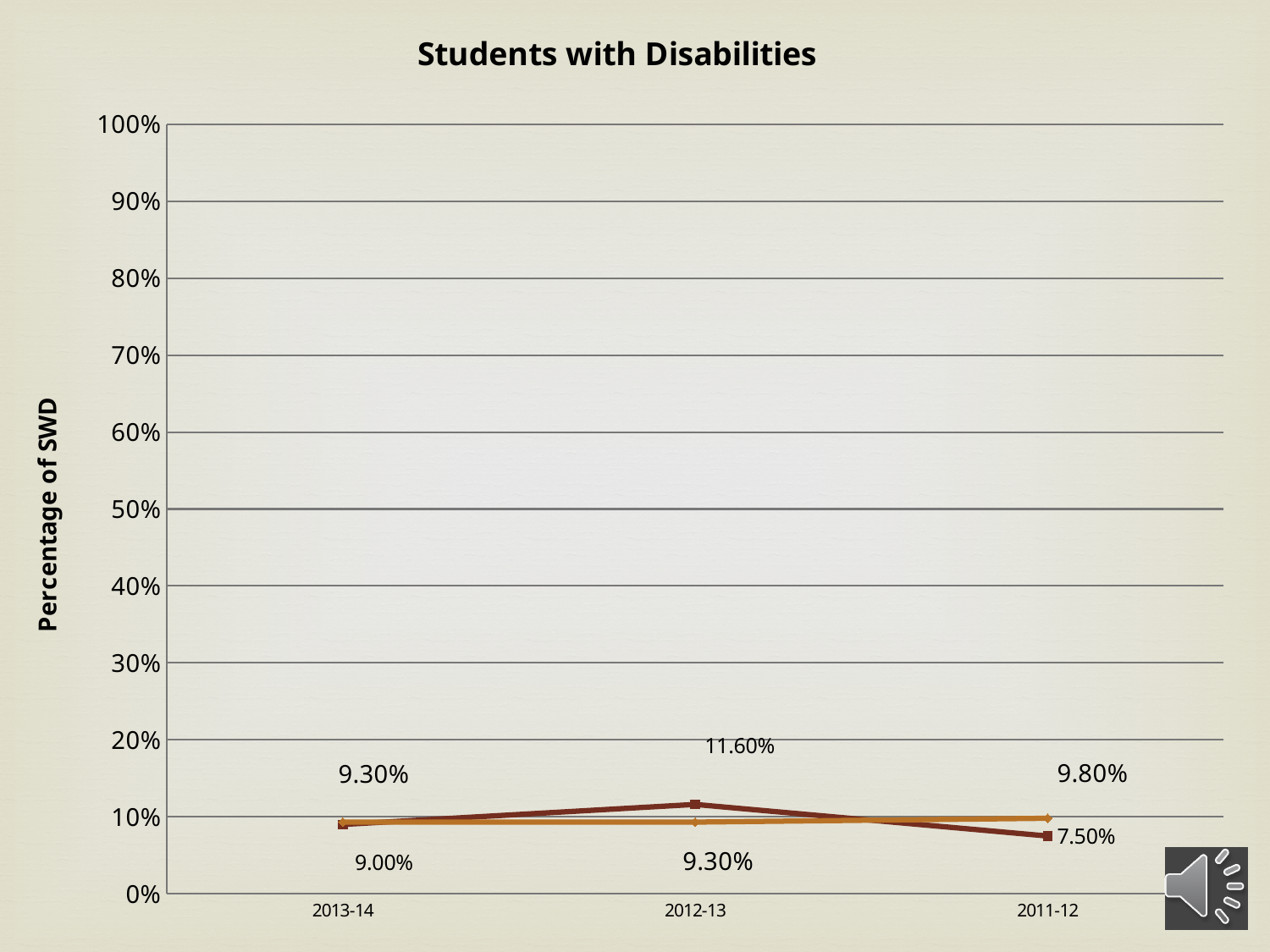
What is the label on the vertical axis of the chart? Percentage of SWD What is the value of the orange line with diamond markers for 2011-12? 9.80% What is the difference between the dark red line's value for 2012-13 (11.60%) and its value for 2011-12 (7.50%)? 4.10% For 2011-12, which line has the larger value, the orange line with diamond markers or the dark red line with square markers? the orange line with diamond markers What is the value of the dark red line with square markers for 2012-13? 11.60% What is the value of the dark red line with square markers for 2011-12? 7.50% In which year does the dark red line with square markers have its lowest value? 2011-12 In which year does the dark red line with square markers reach its highest value? 2012-13 How many categories are shown on the x axis of the chart? 3 What is the title of the chart? Students with Disabilities What is the value of the orange line with diamond markers for 2013-14? 9.30% What type of chart is shown on the slide? line chart